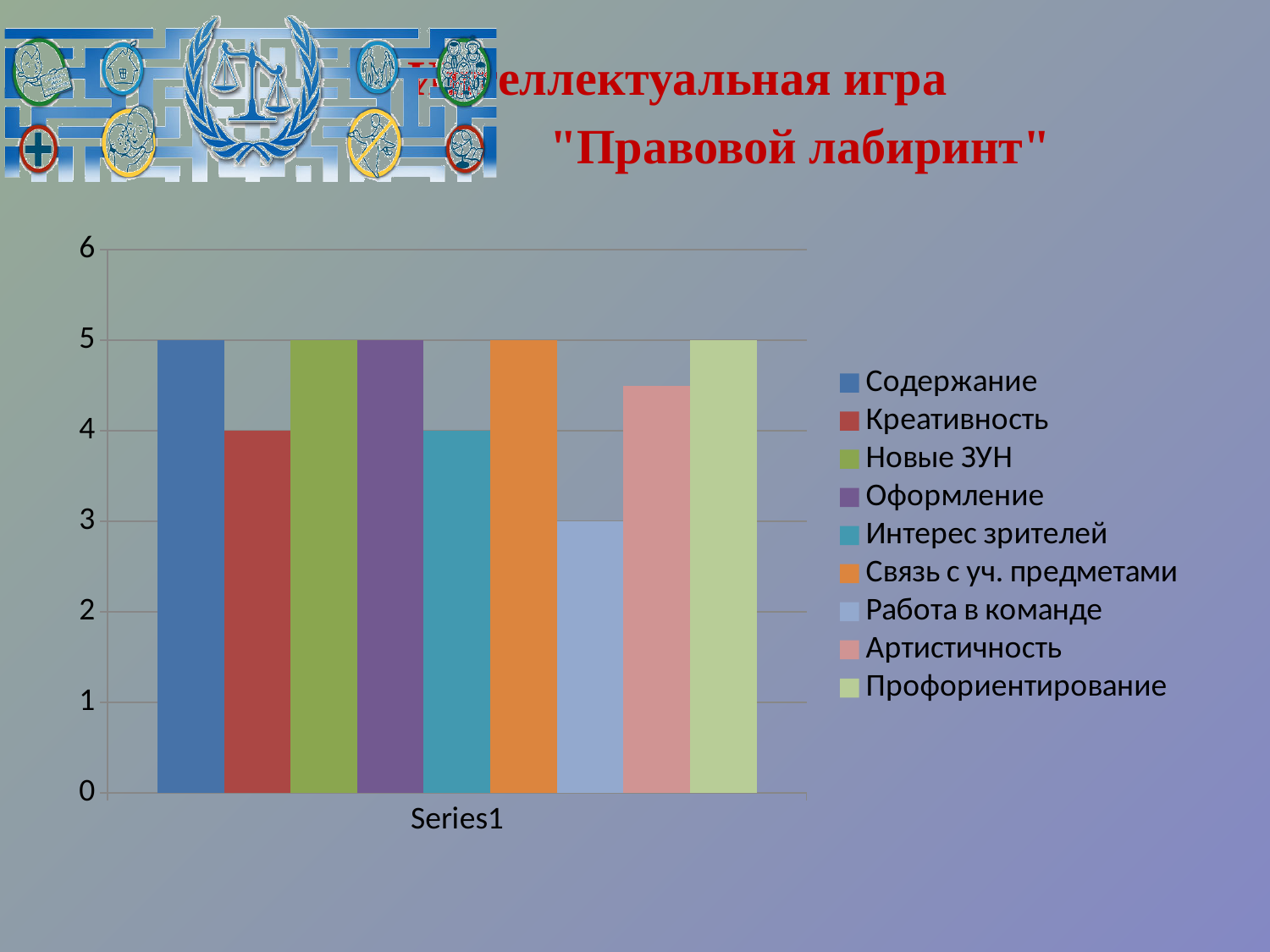
What kind of chart is shown on the slide? bar chart What is the difference between the values for Содержание and Работа в команде? 2 What is the value of the bar for Работа в команде? 3 What is the value of the bar for Интерес зрителей? 4 How many entries does the chart legend list? 9 What label is shown on the horizontal axis of the chart? Series1 Is the value for Артистичность greater or less than 4? greater What is the value of the bar for Содержание? 5 What is the value of the bar for Креативность? 4 Which legend entry has the lowest bar? Работа в команде Which is larger, the value for Креативность or the value for Работа в команде? Креативность Is the value for Артистичность greater or less than 5? less